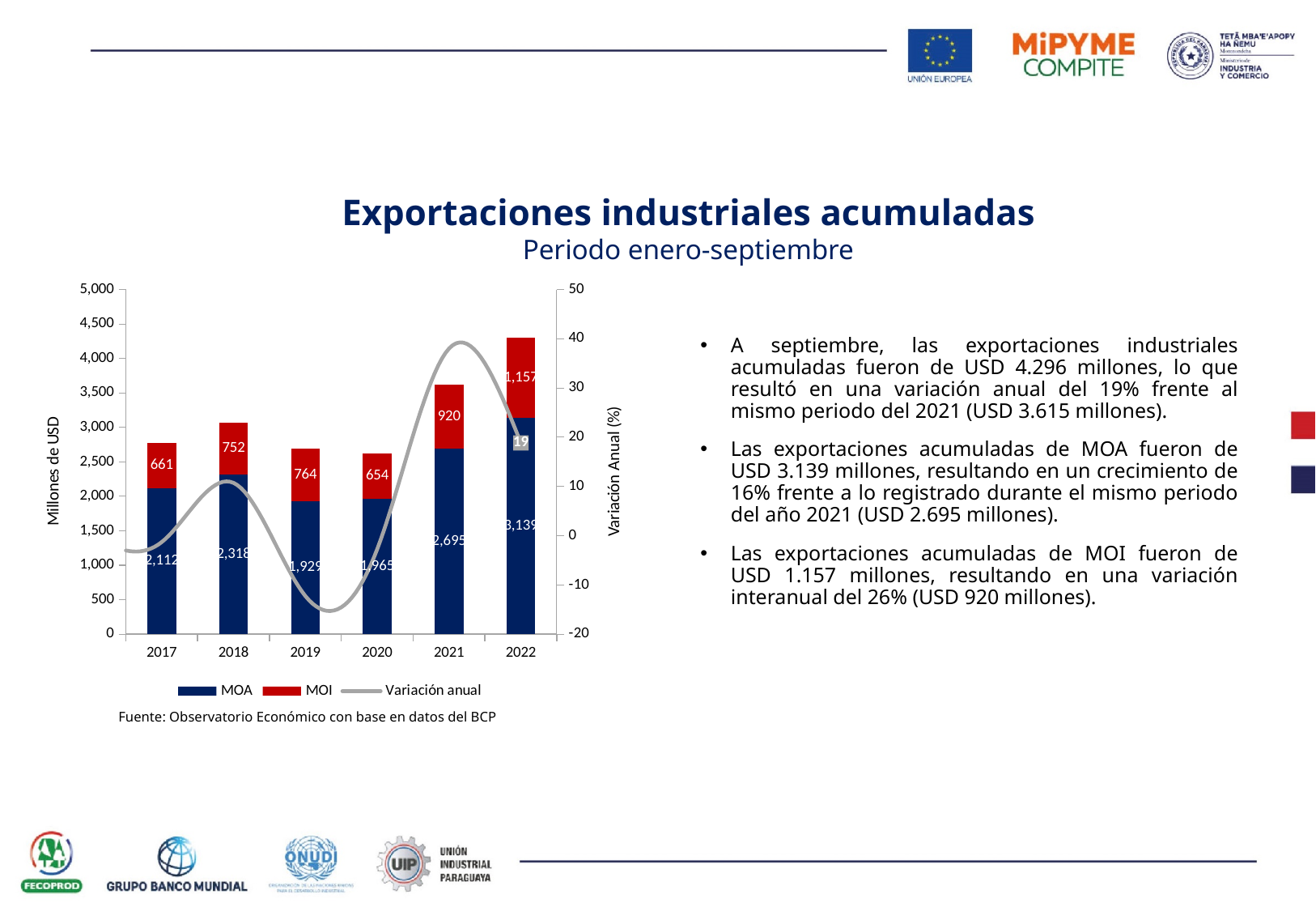
Which is larger, the MOI value for 2019 or the MOI value for 2018? 2019 How many years are shown on the x axis? 6 Which year has the highest MOA value? 2022 What is the label of the left vertical axis? Millones de USD What kind of chart is this? Stacked bar chart with a line How many series does the legend list? 3 What is the MOI value for 2018? 752 What is the Variación anual value shown for 2022? 19 What is the MOA value for 2021? 2,695 What is the difference between the MOA values for 2022 and 2021? 444 What is the total of the stacked bar for 2022 (MOA plus MOI)? 4,296 Which year has the lowest MOI value? 2020